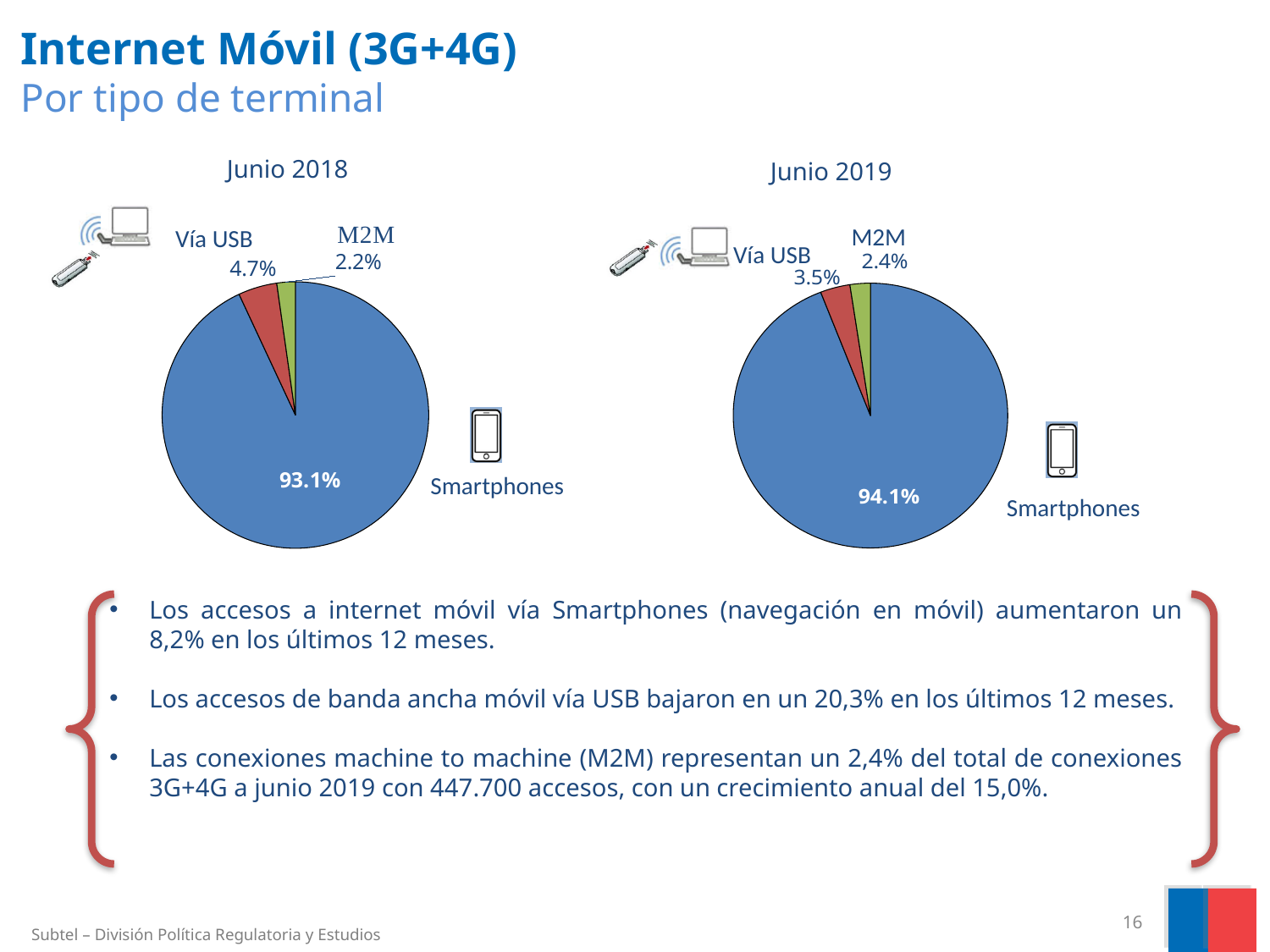
How many categories does the Junio 2018 pie chart show? 3 In the Junio 2019 pie chart, what is the share for M2M? 2.4% What is the difference between the Vía USB share in Junio 2018 and in Junio 2019? 1.2% In the Junio 2018 pie chart, what share do Smartphones have? 93.1% In the Junio 2019 pie chart, which category has the largest share? Smartphones What is the difference between the Smartphones share in Junio 2019 and in Junio 2018? 1.0% In the Junio 2018 pie chart, which category has the smallest share? M2M In the Junio 2018 pie chart, what is the share for Vía USB? 4.7% What colour is the Smartphones slice in the Junio 2018 pie chart? Blue What type of chart is used for Junio 2019? Pie chart In the Junio 2019 pie chart, which is larger, Vía USB or M2M? Vía USB In the Junio 2019 pie chart, what share do Smartphones have? 94.1%